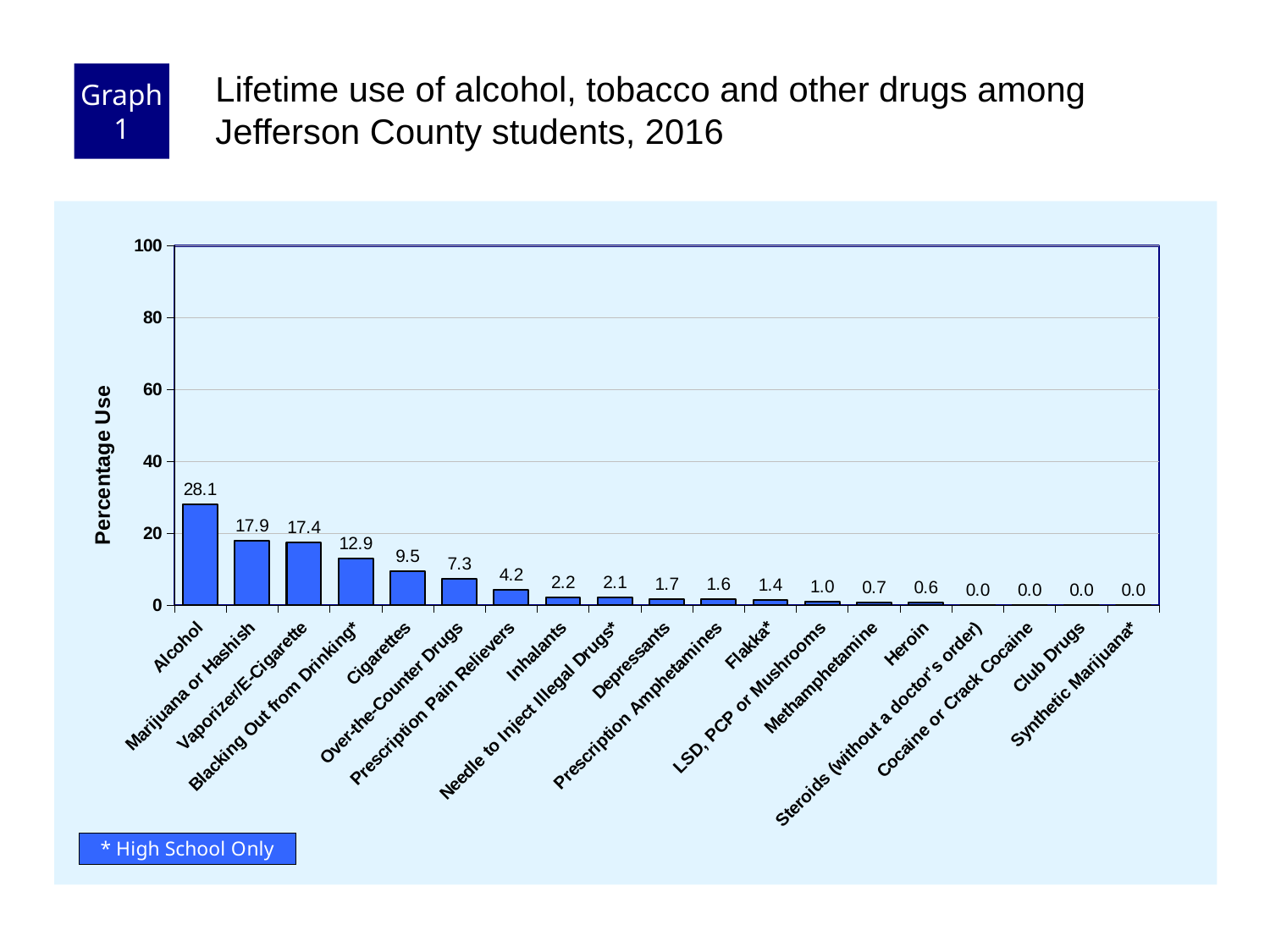
What does the asterisk (*) on some category labels indicate, according to the note on the slide? High School Only What is the difference in percentage use between Alcohol and Marijuana or Hashish? 10.2 Which has a higher percentage use, Cigarettes or Over-the-Counter Drugs? Cigarettes What is the label of the y axis? Percentage Use Is the value for Blacking Out from Drinking* greater or less than 20? less What kind of chart is shown on the slide? Bar chart What is the percentage use for Alcohol? 28.1 What is the percentage use for Cigarettes? 9.5 Which category has the highest percentage use? Alcohol How many categories are shown on the x axis? 19 What is the percentage use for Heroin? 0.6 Do the values rise or fall moving from left to right along the x axis? Fall